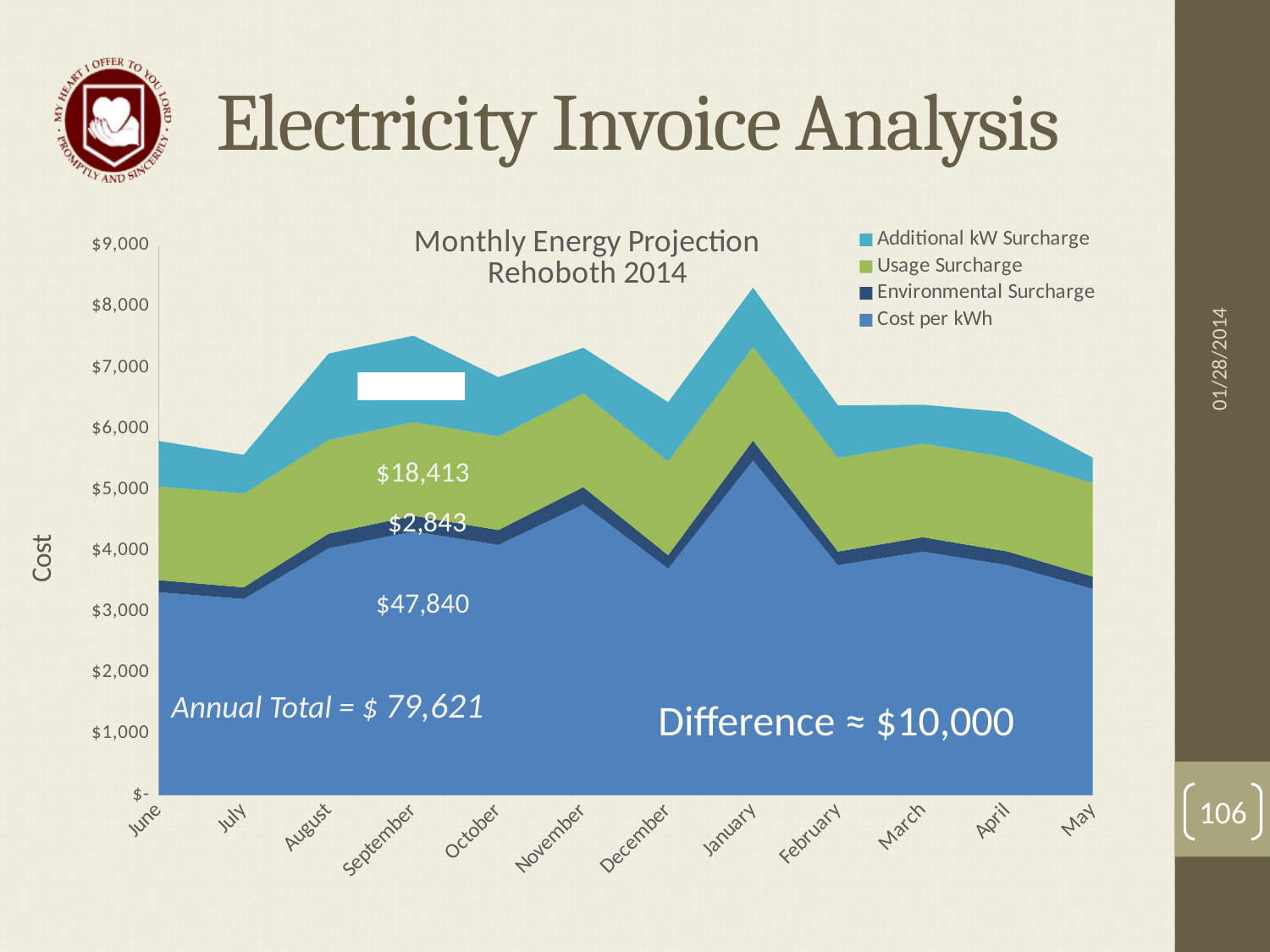
What kind of chart is shown on the slide? area chart From January to May, does the total stacked cost rise or fall? fall Is the total stacked cost for June greater or less than $6,000? less Which month has the larger total stacked cost, January or December? January How many series does the legend of the chart list? 4 What annual total is stated in the text on the chart? $ 79,621 Is the total stacked cost for January greater or less than $8,000? greater Is the Cost per kWh value for June greater or less than $4,000? less How many months are shown along the x axis of the chart? 12 What is the title of the chart? Monthly Energy Projection Rehoboth 2014 In which month is the total stacked cost highest? January